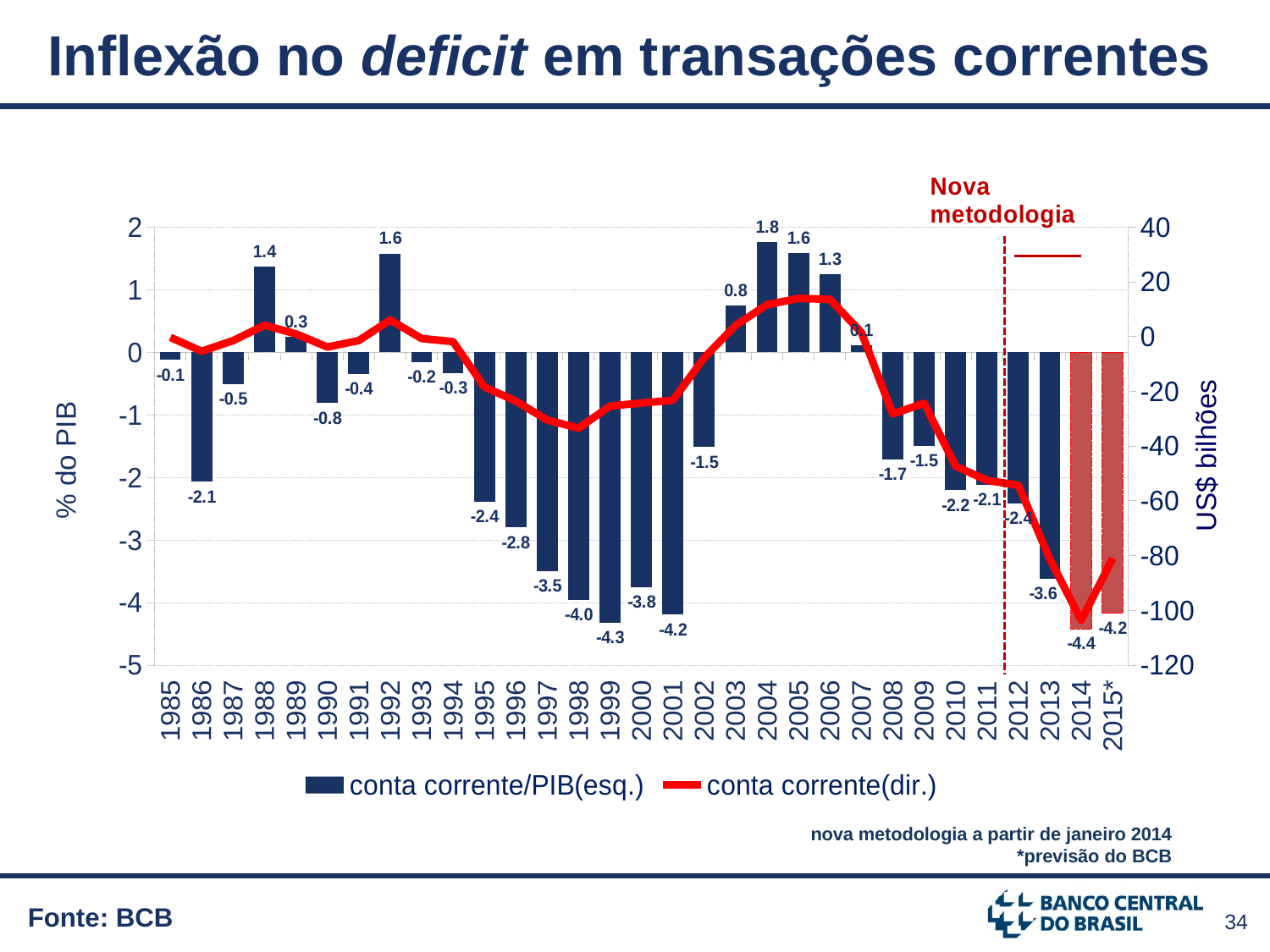
What is the value of conta corrente/PIB for 2014? -4.4 How many years are shown on the x axis of the chart? 31 Is the conta corrente (dir.) line value for 2005 greater or less than 0 US$ bilhões? greater What kind of chart is shown on the slide? Combined bar and line chart Which year has a larger conta corrente/PIB value, 1988 or 1992? 1992 Which year has the highest conta corrente/PIB bar? 2004 What is the value of conta corrente/PIB for 2004? 1.8 What is the value of conta corrente/PIB for 1999? -4.3 What is the difference between the conta corrente/PIB values for 2014 and 2015*? 0.2 Is the conta corrente (dir.) line value for 2013 greater or less than -60 US$ bilhões? less Which year has the lowest conta corrente/PIB bar? 2014 How many series does the chart legend list? 2